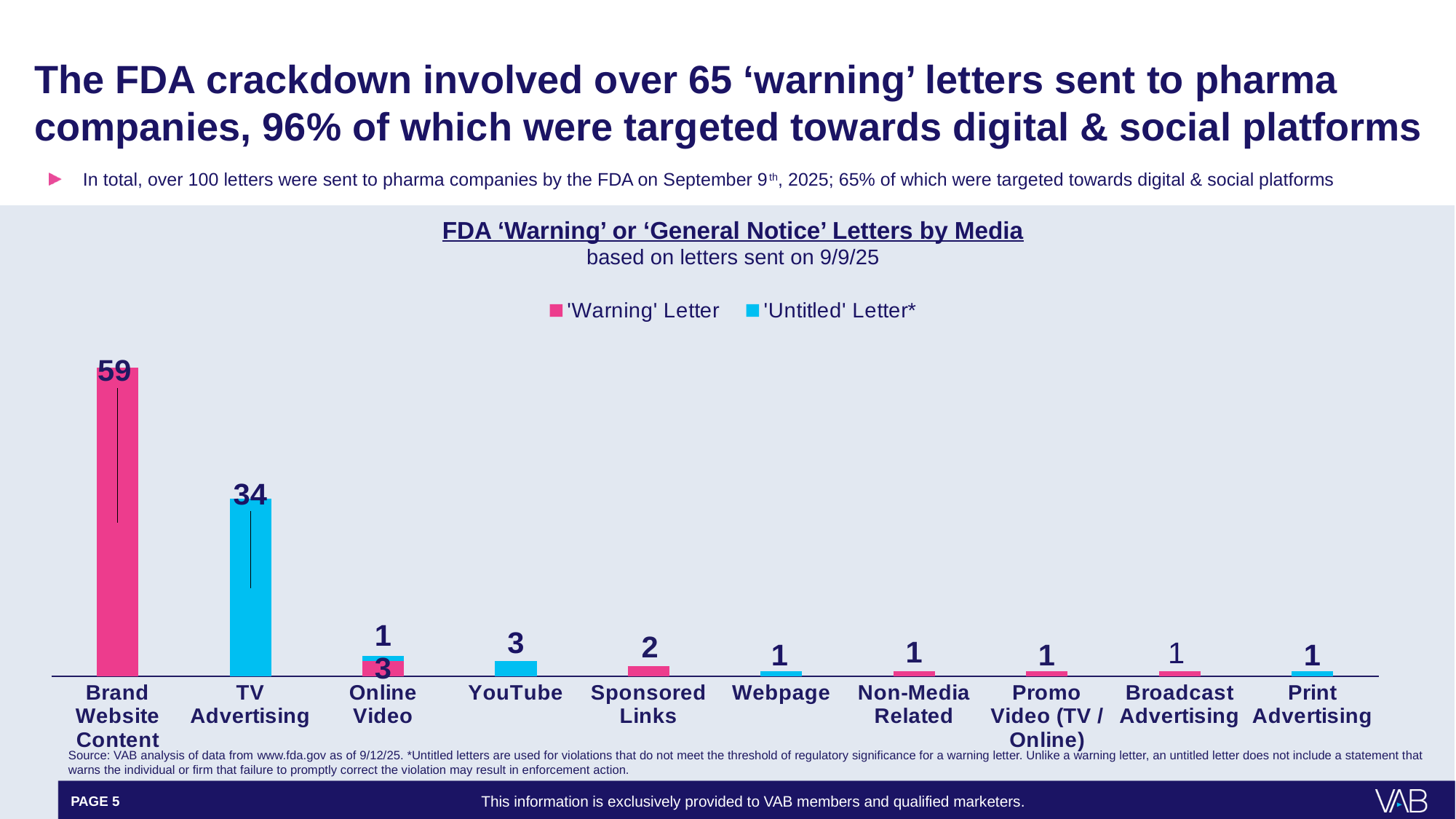
How many 'Untitled' Letters were sent for TV Advertising? 34 Which has the larger value, YouTube or Sponsored Links? YouTube What is the difference between the Brand Website Content value (59) and the TV Advertising value (34)? 25 How many series does the legend list? 2 How many media categories are shown on the x axis? 10 Which media category has the tallest bar in the chart? Brand Website Content How many 'Untitled' Letters were sent for YouTube? 3 How many 'Warning' Letters were sent for Brand Website Content? 59 What kind of chart is shown on the slide? Bar chart How many 'Warning' Letters were sent for Online Video? 3 What is the title of the chart? FDA 'Warning' or 'General Notice' Letters by Media What is the total of the stacked bar for Online Video? 4